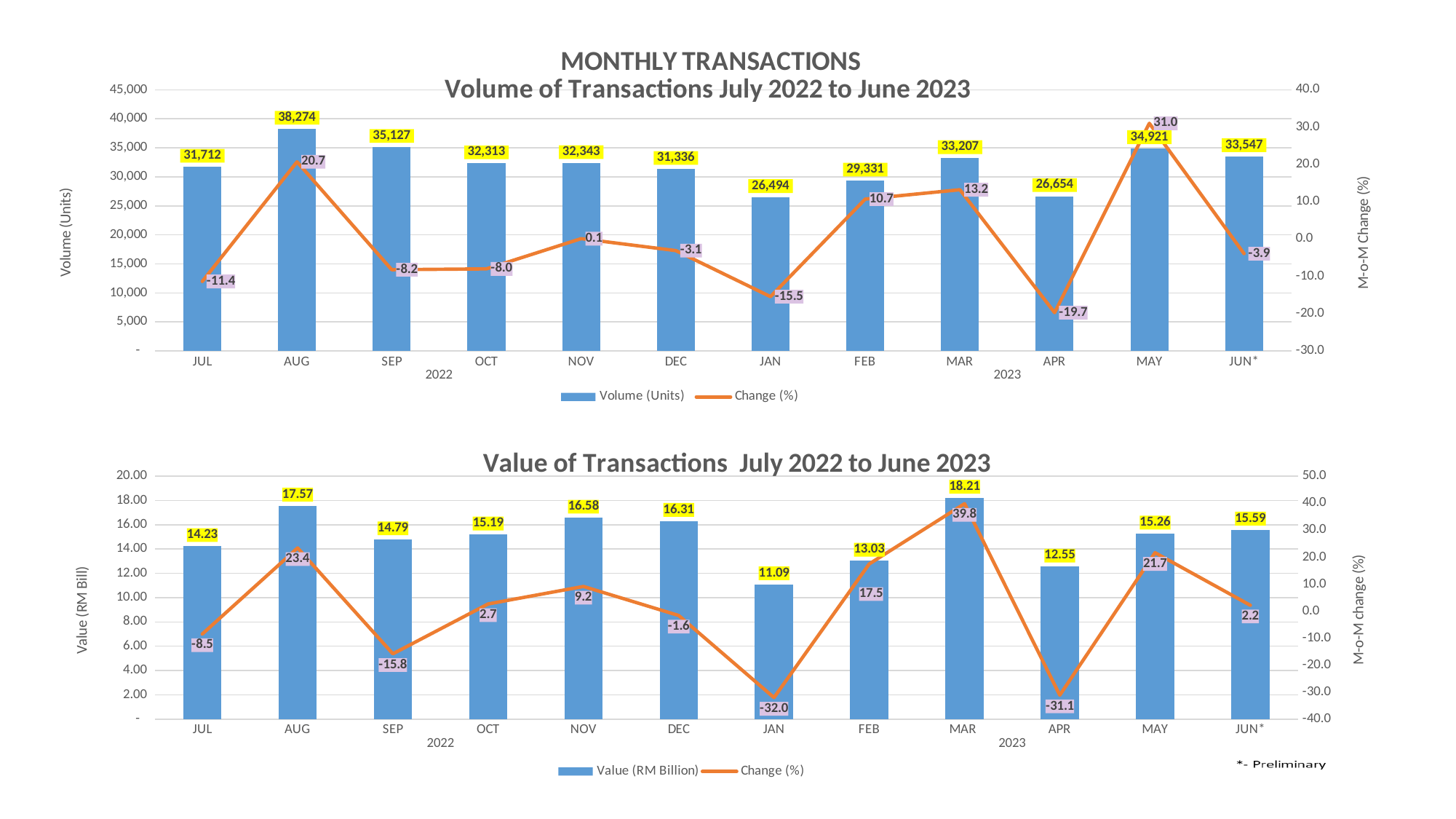
In the Value of Transactions chart, what is the difference in value between AUG 2022 and JUL 2022? 3.34 In the Volume of Transactions chart, how many series does the legend list? 2 In the Volume of Transactions chart, what is the volume for AUG 2022? 38,274 In the Value of Transactions chart, how many months are plotted? 12 In the Volume of Transactions chart, what is the M-o-M change (%) for APR 2023? -19.7 In the Volume of Transactions chart, which month has the lowest volume? JAN In the Value of Transactions chart, what is the M-o-M change (%) for JAN 2023? -32.0 In the Value of Transactions chart, what is the value for MAR 2023? 18.21 In the Value of Transactions chart, which is larger, the value for NOV 2022 or DEC 2022? NOV 2022 In the Volume of Transactions chart, what is the difference in volume between MAY 2023 and APR 2023? 8,267 What does the asterisk on JUN indicate, according to the note on the slide? Preliminary In the Value of Transactions chart, which month has the highest value? MAR